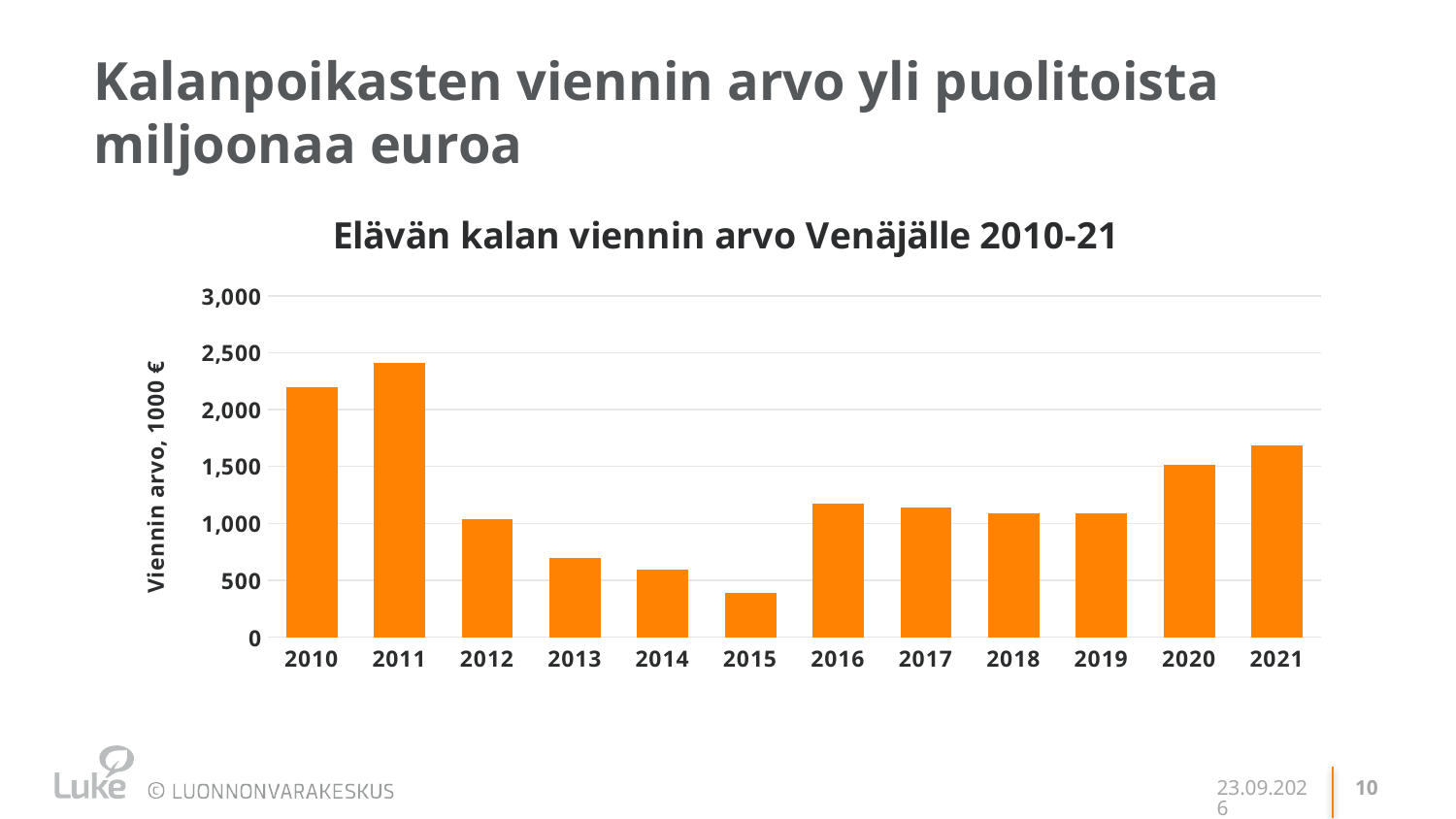
Which year has the larger value, 2010 or 2021? 2010 Which year has the highest export value? 2011 How many years are shown on the x axis of the chart? 12 What is the label of the vertical axis? Viennin arvo, 1000 € Which year has the lowest export value? 2015 What is the title of the chart? Elävän kalan viennin arvo Venäjälle 2010-21 What kind of chart is shown on the slide? bar chart Is the value for 2013 greater or less than 1,000? less Is the value for 2011 greater or less than 2,000? greater Is the value for 2015 greater or less than 500? less Do the values rise or fall from 2011 to 2015? fall